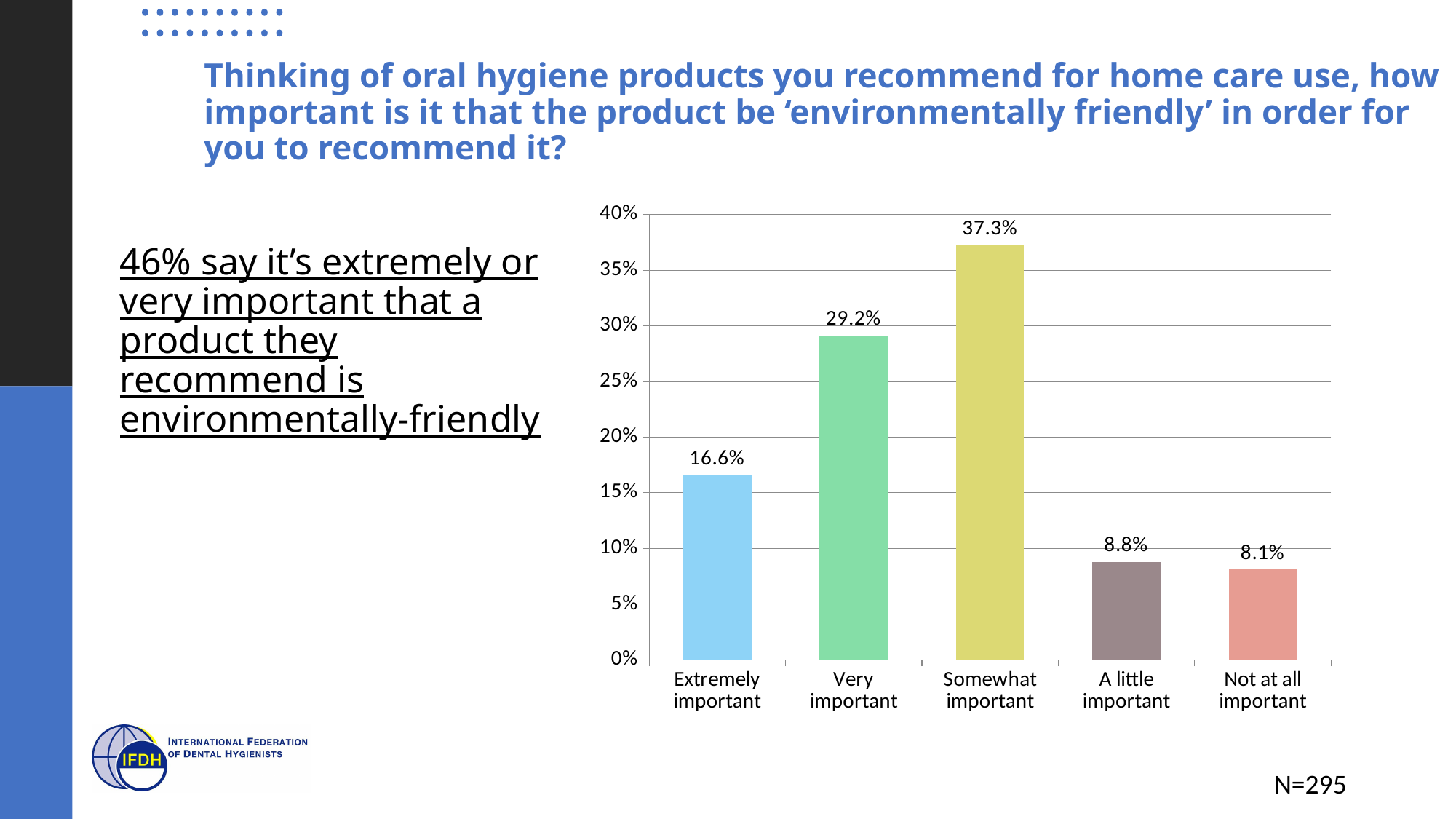
What kind of chart is shown on the slide? Bar chart What is the sample size (N) shown on the slide? N=295 Is the value for 'Very important' greater or less than 25%? greater What is the difference in percentage points between 'Somewhat important' and 'Very important'? 8.1 What percentage of respondents said 'environmentally friendly' is extremely important? 16.6% How many categories are shown on the x axis? 5 What percentage of respondents said it is not at all important? 8.1% Which is larger, the value for 'Very important' or the value for 'Extremely important'? Very important What is the difference in percentage points between 'Extremely important' and 'A little important'? 7.8 Which category has the highest percentage? Somewhat important What percentage of respondents said it is somewhat important? 37.3% Which category has the lowest percentage? Not at all important